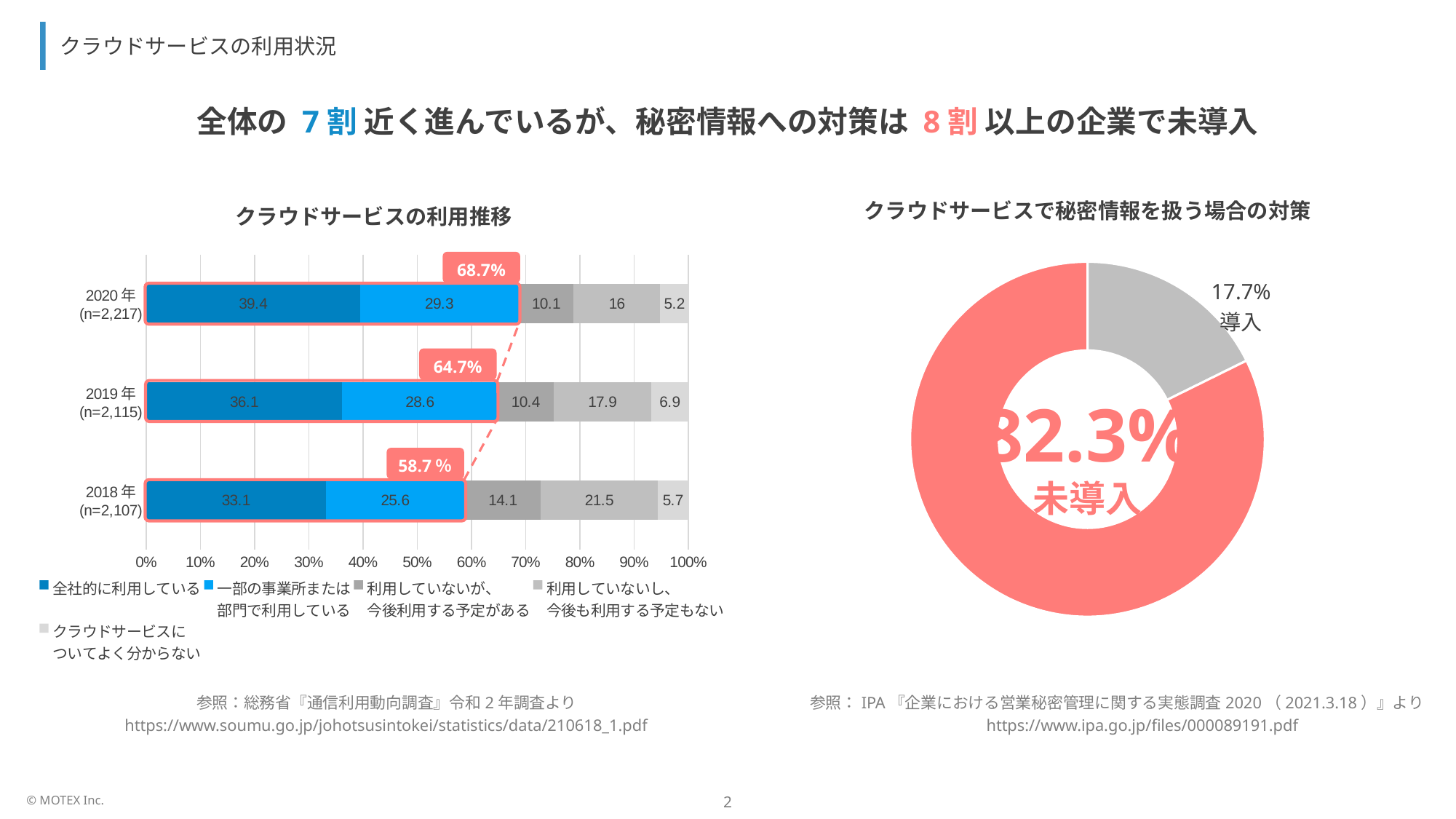
In the chart titled クラウドサービスで秘密情報を扱う場合の対策, what share is 導入? 17.7% In the chart titled クラウドサービスの利用推移, how many series does the legend list? 5 In the chart titled クラウドサービスの利用推移, what is the difference between the 全社的に利用している values for 2020年 and 2018年? 6.3 In the chart titled クラウドサービスの利用推移, what combined utilization percentage is highlighted for 2019年? 64.7% In the chart titled クラウドサービスの利用推移, how many years are shown? 3 In the chart titled クラウドサービスの利用推移, does the highlighted combined utilization percentage rise or fall from 2018年 to 2020年? Rises In the chart titled クラウドサービスの利用推移, what is the value for 全社的に利用している in 2020年? 39.4 What kind of chart is the chart titled クラウドサービスの利用推移? Stacked bar chart In the chart titled クラウドサービスで秘密情報を扱う場合の対策, what share is 未導入? 82.3% In the chart titled クラウドサービスの利用推移, which year has the larger value for 一部の事業所または部門で利用している, 2019年 or 2018年? 2019年 In the chart titled クラウドサービスの利用推移, what is the value for 利用していないし、今後も利用する予定もない in 2018年? 21.5 In the chart titled クラウドサービスの利用推移, which year has the highest value for 全社的に利用している? 2020年